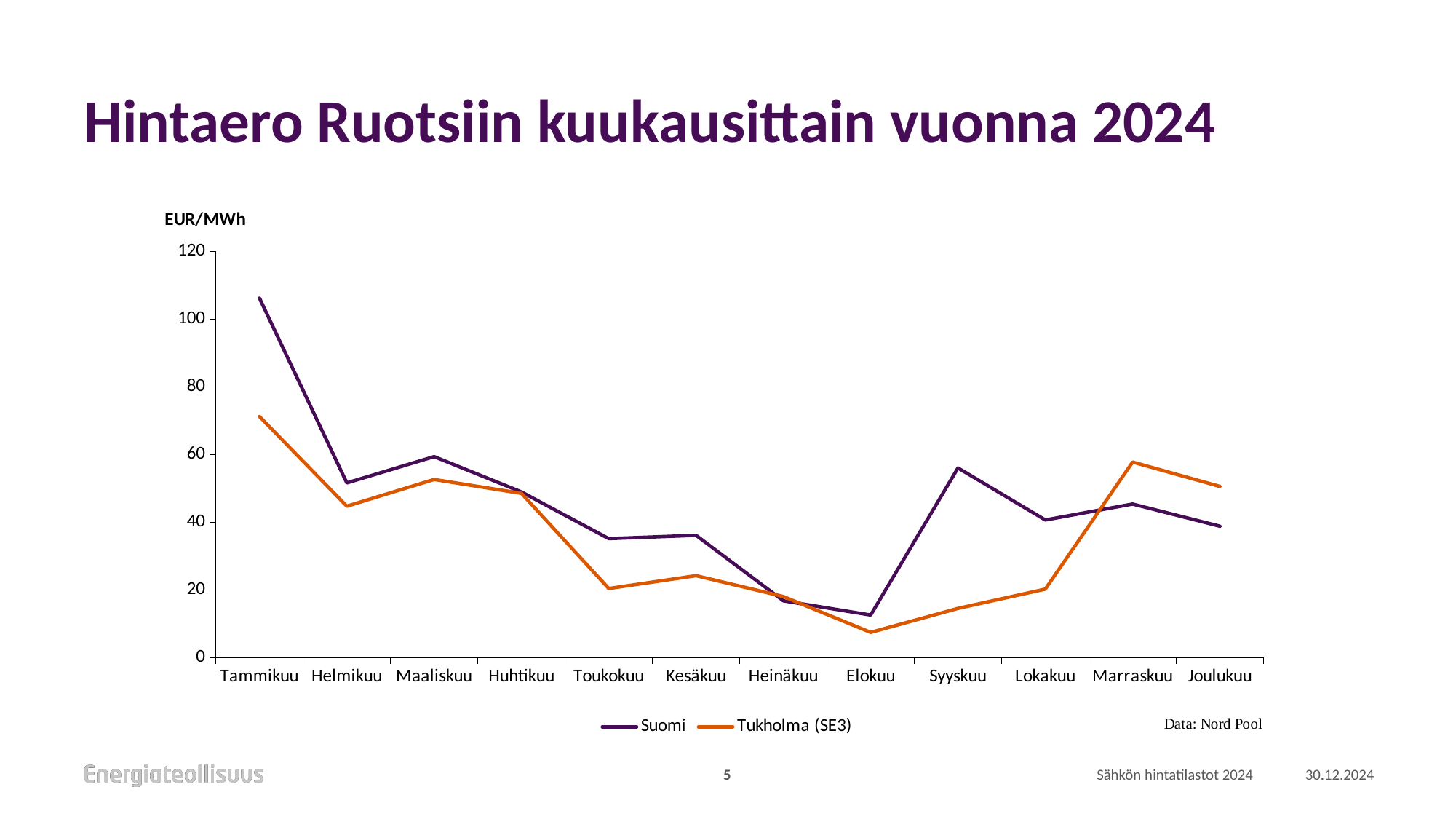
In which month is the Tukholma (SE3) value lowest? Elokuu In which month is the Suomi value highest? Tammikuu In which month is the Tukholma (SE3) value highest? Tammikuu In which month is the Suomi value lowest? Elokuu In Syyskuu, which series has the larger value, Suomi or Tukholma (SE3)? Suomi In Marraskuu, which series has the larger value, Suomi or Tukholma (SE3)? Tukholma (SE3) Is the Suomi value for Tammikuu greater or less than 100? greater Is the Tukholma (SE3) value for Toukokuu greater or less than 40? less What unit is shown on the y axis? EUR/MWh How many series does the legend list? 2 What kind of chart is shown on the slide? line chart How many months are shown on the x axis? 12